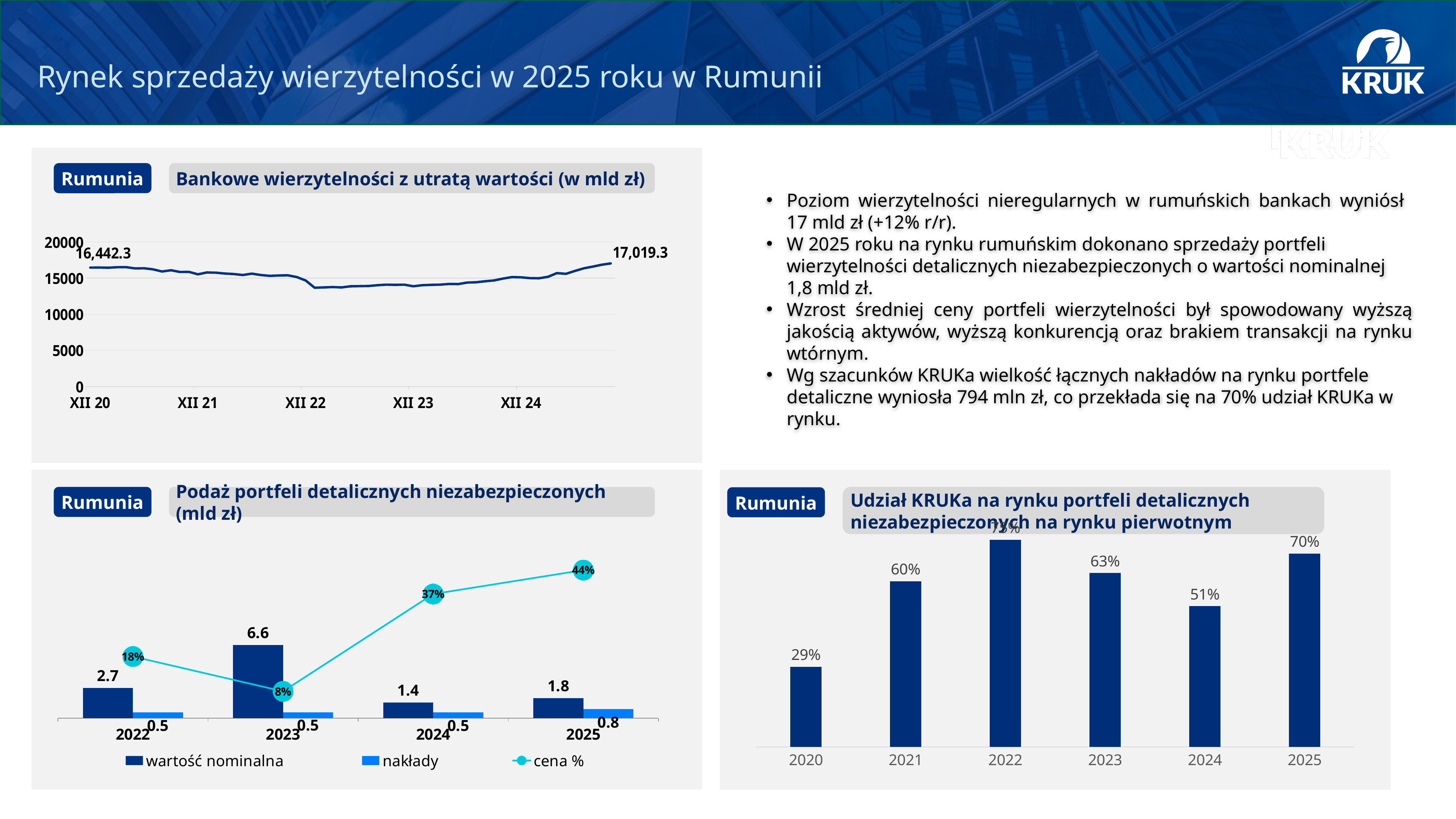
In the chart 'Podaż portfeli detalicznych niezabezpieczonych (mld zł)', what is the nakłady value for 2025? 0.8 In the chart 'Udział KRUKa na rynku portfeli detalicznych niezabezpieczonych na rynku pierwotnym', which year has the lowest value? 2020 How many series does the legend of the chart 'Podaż portfeli detalicznych niezabezpieczonych (mld zł)' list? 3 In the chart 'Bankowe wierzytelności z utratą wartości (w mld zł)', what is the value labelled at the start of the line? 16,442.3 In the chart 'Udział KRUKa na rynku portfeli detalicznych niezabezpieczonych na rynku pierwotnym', what is the difference between the values for 2025 and 2024? 19% In the chart 'Udział KRUKa na rynku portfeli detalicznych niezabezpieczonych na rynku pierwotnym', what is the value for 2021? 60% In the chart 'Podaż portfeli detalicznych niezabezpieczonych (mld zł)', which year has the lowest wartość nominalna? 2024 What kind of chart is 'Bankowe wierzytelności z utratą wartości (w mld zł)'? line chart In the chart 'Podaż portfeli detalicznych niezabezpieczonych (mld zł)', what is the difference between the wartość nominalna for 2023 and 2022? 3.9 In the chart 'Bankowe wierzytelności z utratą wartości (w mld zł)', what is the value labelled at the end of the line? 17,019.3 In the chart 'Podaż portfeli detalicznych niezabezpieczonych (mld zł)', what is the cena % for 2024? 37% In the chart 'Podaż portfeli detalicznych niezabezpieczonych (mld zł)', what is the wartość nominalna for 2023? 6.6